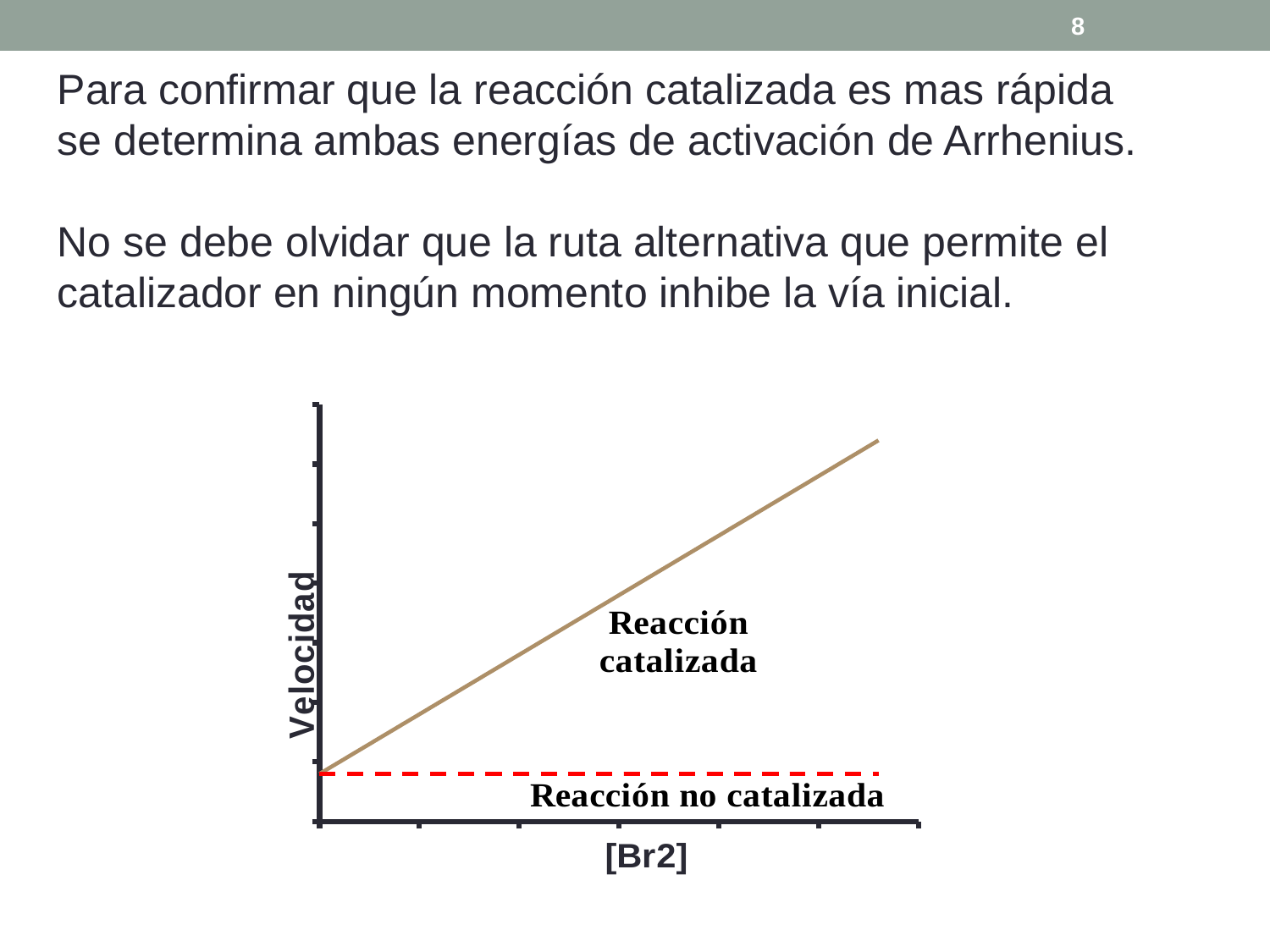
At high [Br2], which line shows the greater Velocidad: 'Reacción catalizada' or 'Reacción no catalizada'? Reacción catalizada How many lines (series) are plotted on the chart? 2 What is the label on the x axis of the chart? [Br2] What is the label on the y axis of the chart? Velocidad Does the line for 'Reacción no catalizada' rise, fall, or stay flat as [Br2] increases? stays flat Which of the two plotted reactions has the lower Velocidad across the chart? Reacción no catalizada What kind of chart is shown on the slide? line chart Does the line for 'Reacción catalizada' rise or fall as [Br2] increases? rises